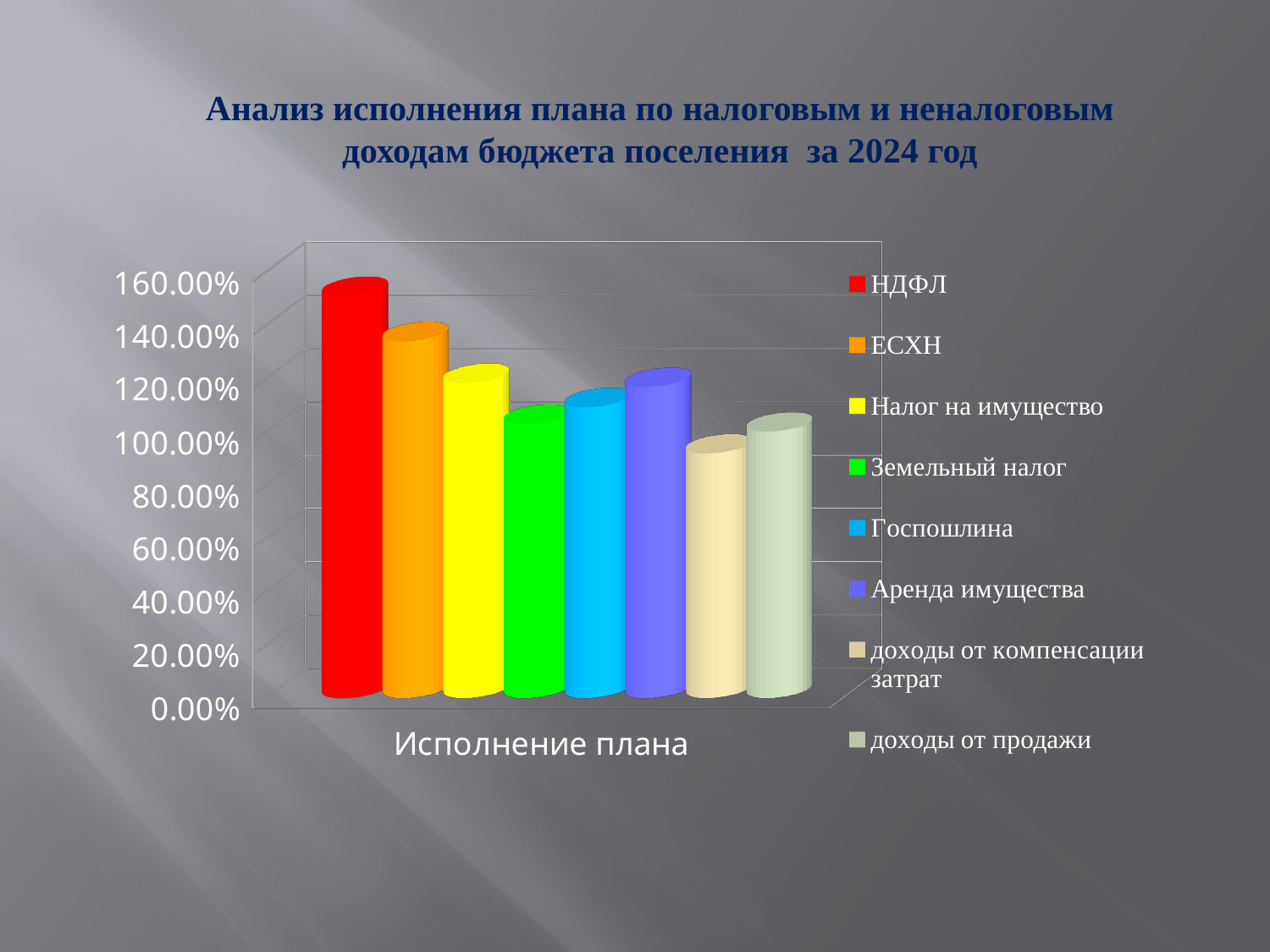
Which is larger, the value for Налог на имущество or the value for доходы от продажи? Налог на имущество Is the value for ЕСХН greater or less than 120.00%? greater Is the value for доходы от компенсации затрат greater or less than 120.00%? less How many series does the legend list? 8 Which is larger, the value for НДФЛ or the value for ЕСХН? НДФЛ Which series has the lowest value? доходы от компенсации затрат Which series has the highest value? НДФЛ How many categories are shown on the x axis? 1 What is the category label on the x axis? Исполнение плана What kind of chart is shown on the slide? bar chart What colour is the bar for НДФЛ? red Is the value for НДФЛ greater or less than 140.00%? greater